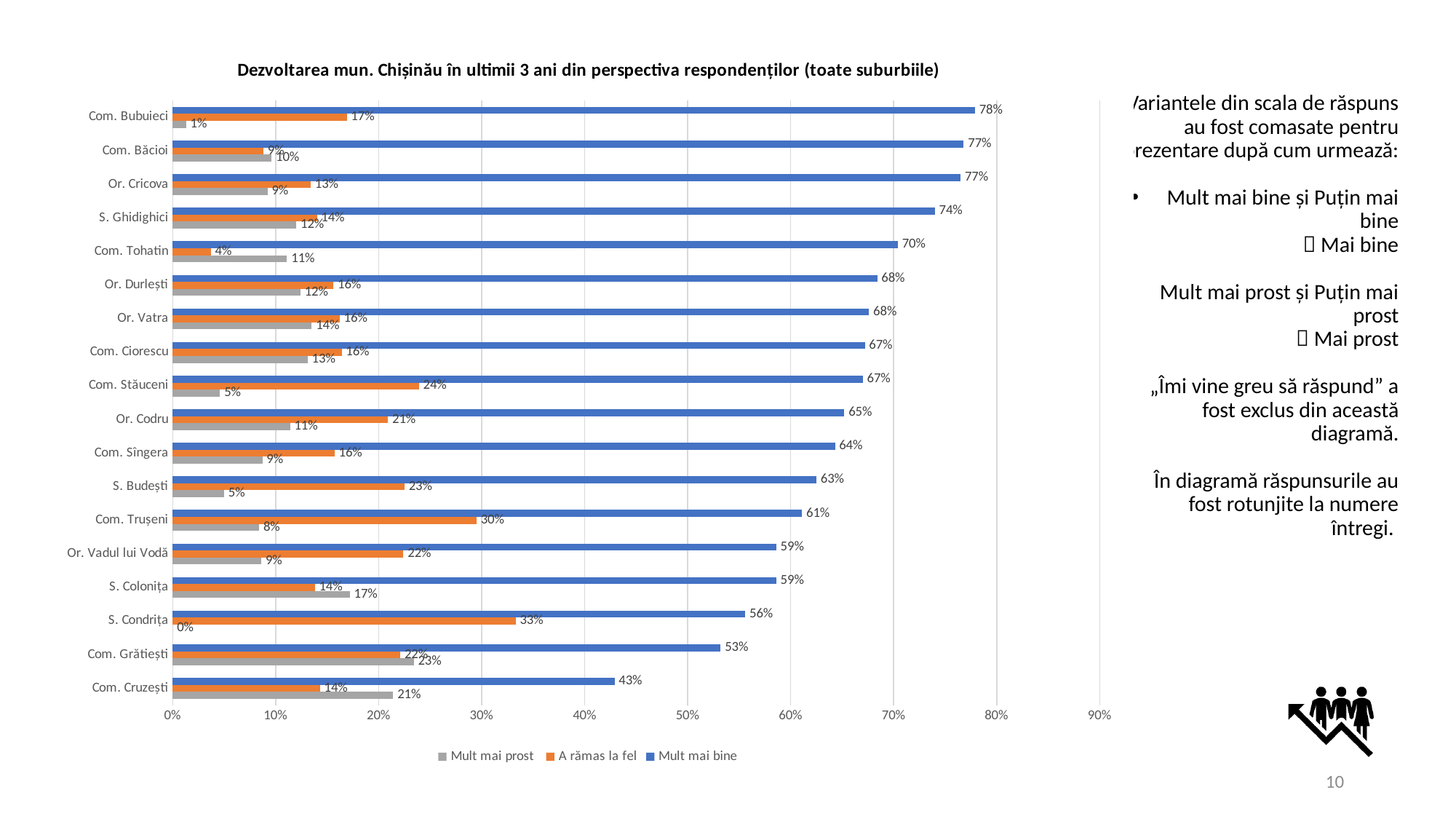
What is the 'A rămas la fel' value for S. Condrița? 33% What is the 'Mult mai bine' value for Com. Tohatin? 70% Which colour represents the 'A rămas la fel' series? Orange What is the difference between the 'Mult mai bine' values for Com. Bubuieci and Com. Cruzești? 35% How many series does the legend list? 3 Which category has the highest 'Mult mai bine' value? Com. Bubuieci How many categories (localities) are shown in the chart? 18 What is the 'Mult mai prost' value for Com. Grătiești? 23% What type of chart is shown on the slide? Bar chart Which category has the lowest 'Mult mai bine' value? Com. Cruzești What is the 'Mult mai bine' value for Com. Bubuieci? 78% Which is larger for Com. Trușeni: 'A rămas la fel' or 'Mult mai prost'? A rămas la fel